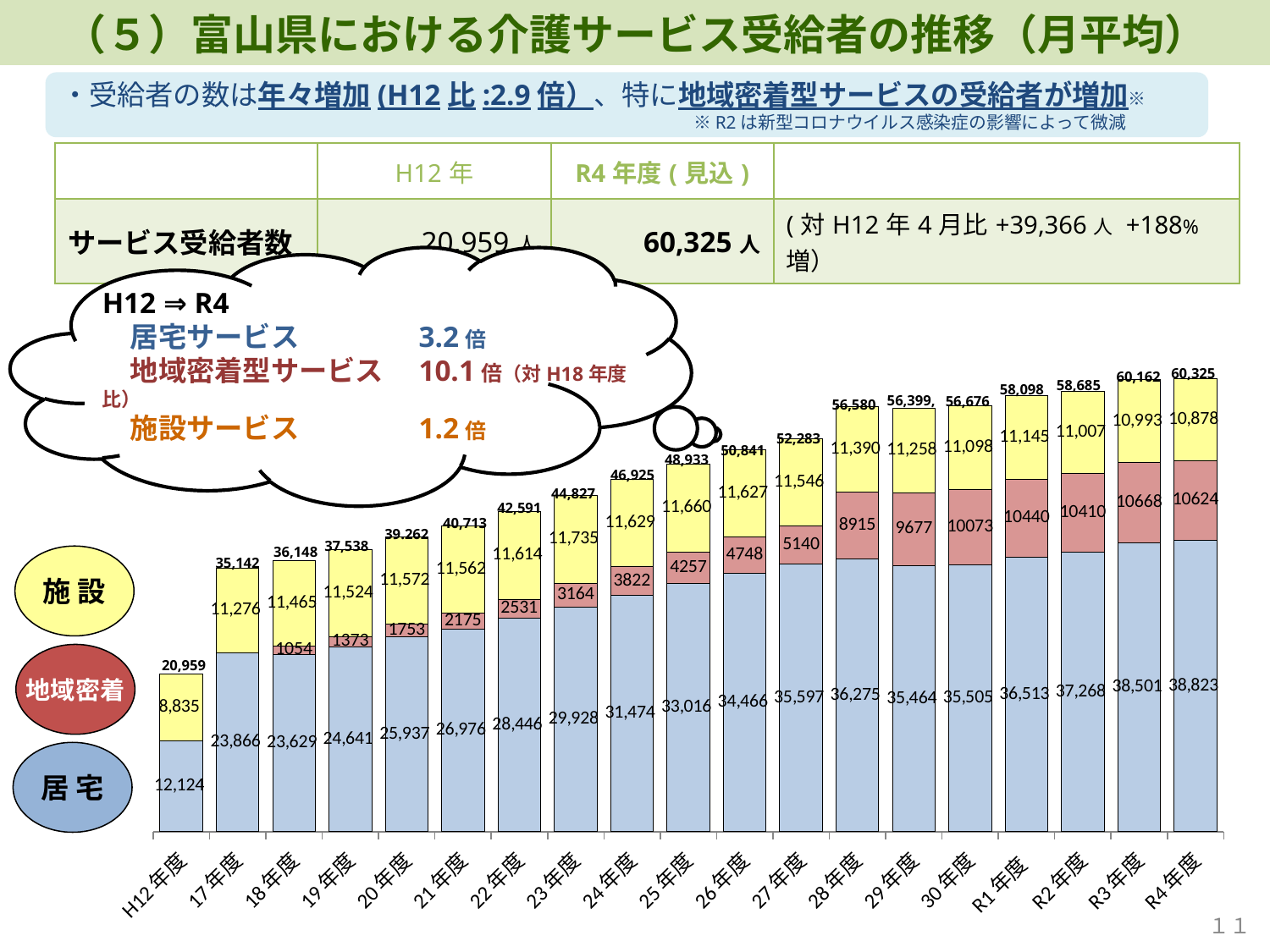
Do the total recipient values generally rise or fall from H12年度 to R4年度? rise What is the total number of recipients shown for H12年度? 20,959 Which fiscal year has the lowest total number of recipients? H12年度 What type of chart is shown on the slide? stacked bar chart How many series (service types) does the chart's legend list? 3 What is the difference between the total for R4年度 and the total for H12年度? 39,366 Which fiscal year has the highest total number of recipients? R4年度 What is the 地域密着 (community-based) value for 28年度? 8915 What is the 居宅 (home service) value for R4年度? 38,823 What is the 施設 (facility) value for 23年度? 11,735 Which is larger, the 施設 value for 22年度 or the 施設 value for R4年度? 22年度 How many fiscal-year categories are plotted along the x axis of the chart? 19